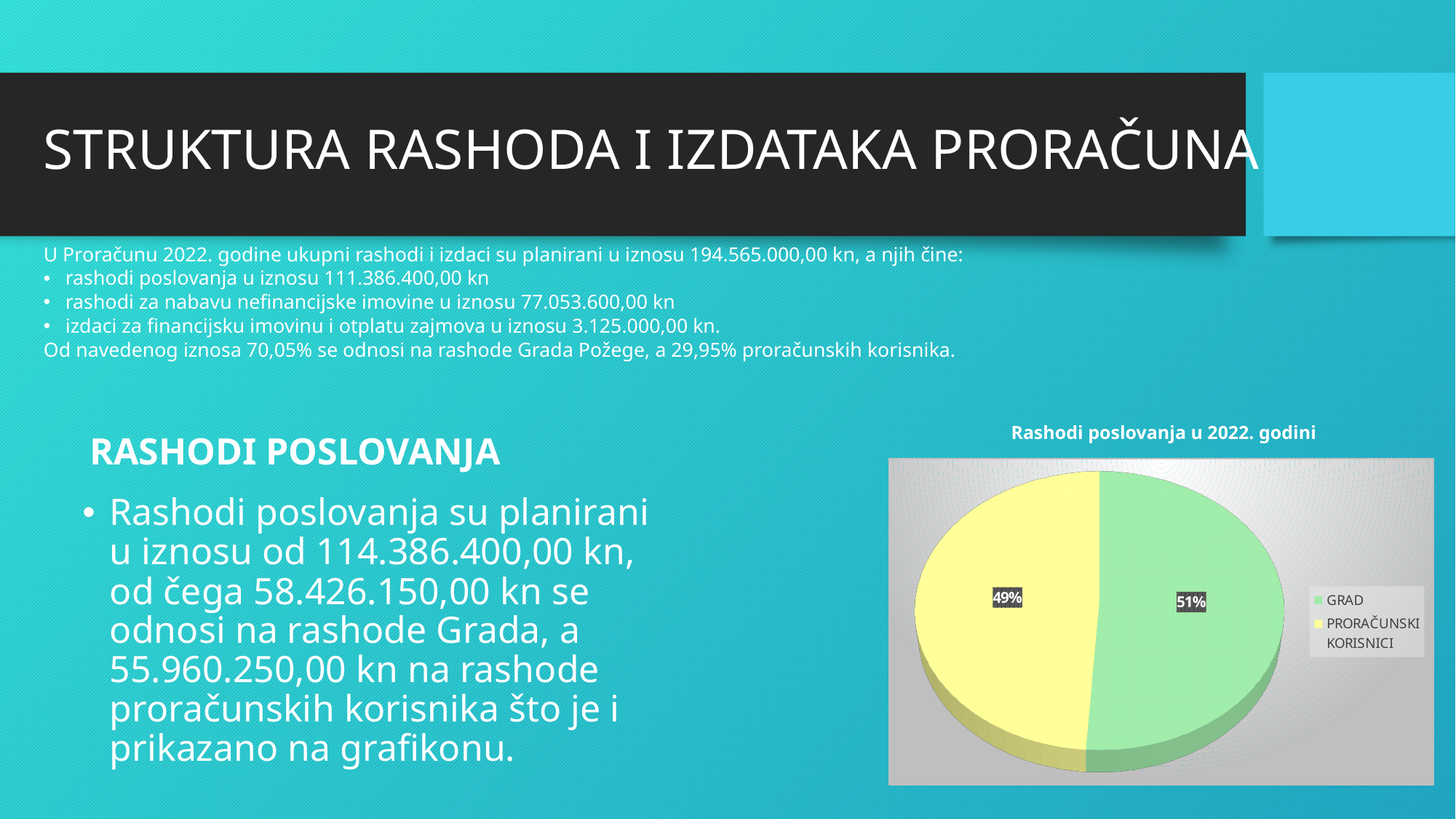
What is the difference in percentage points between the GRAD slice and the PRORAČUNSKI KORISNICI slice? 2% Which is larger, the GRAD slice or the PRORAČUNSKI KORISNICI slice? GRAD What is the title of the chart? Rashodi poslovanja u 2022. godini Which slice of the pie is the smallest? PRORAČUNSKI KORISNICI What type of chart is shown on the slide? pie chart What colour is the GRAD slice in the pie chart? green What share of the pie does PRORAČUNSKI KORISNICI represent? 49% How many entries does the legend list? 2 What share of the pie does GRAD represent? 51% How many slices does the pie chart have? 2 Which slice of the pie is the largest? GRAD